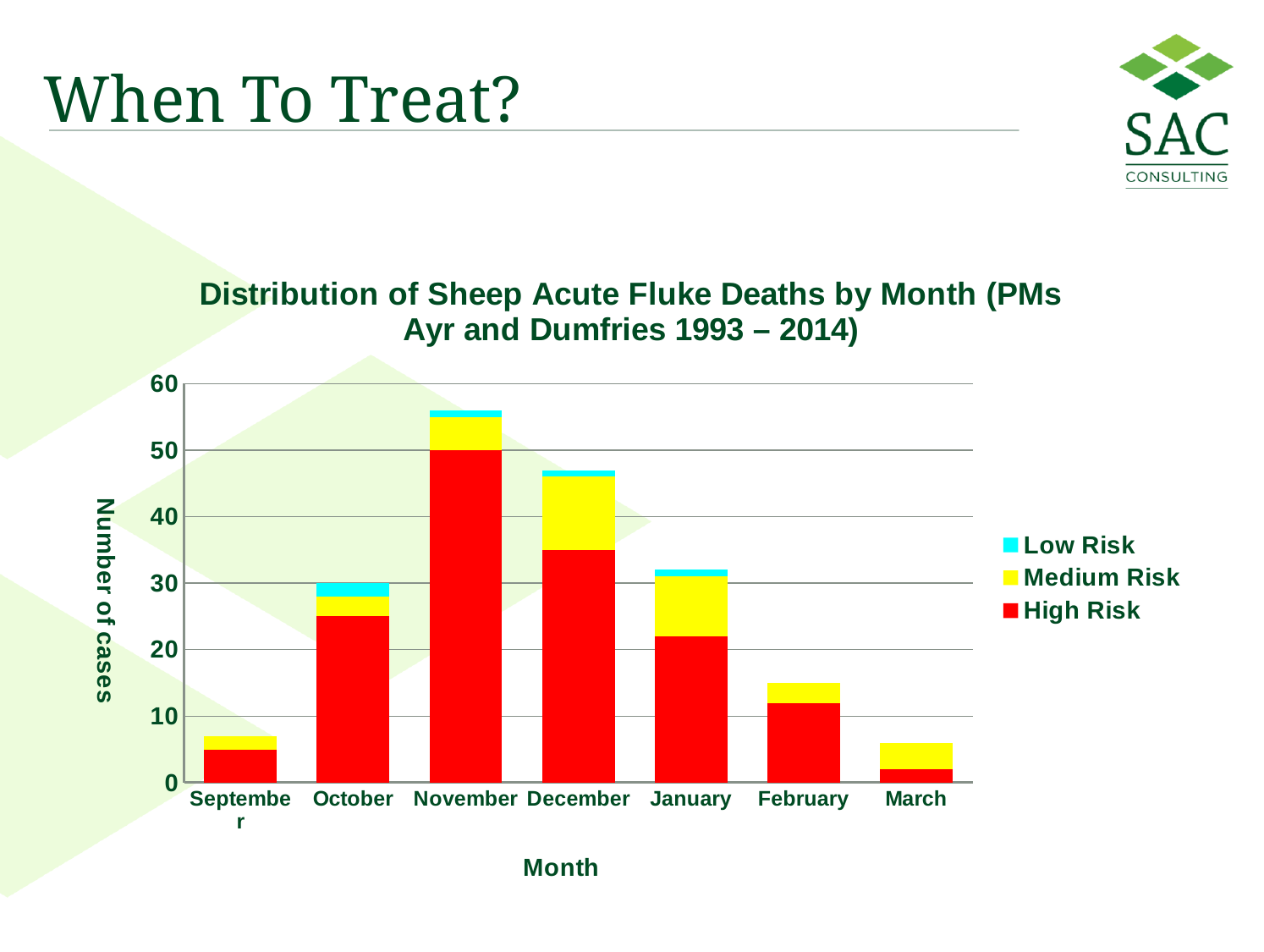
Is the total number of cases for December greater or less than 40? greater How many series does the chart's legend list? 3 Which month has the larger total number of cases, January or February? January Is the total number of cases for November greater or less than 50? greater Is the total number of cases for February greater or less than 20? less Which month has the larger total number of cases, October or December? December Which month has the highest total number of cases? November Do the total number of cases rise or fall from November to March? fall What kind of chart is shown on the slide? Stacked bar chart What is the title of the chart's vertical axis? Number of cases How many months are shown on the x axis of the chart? 7